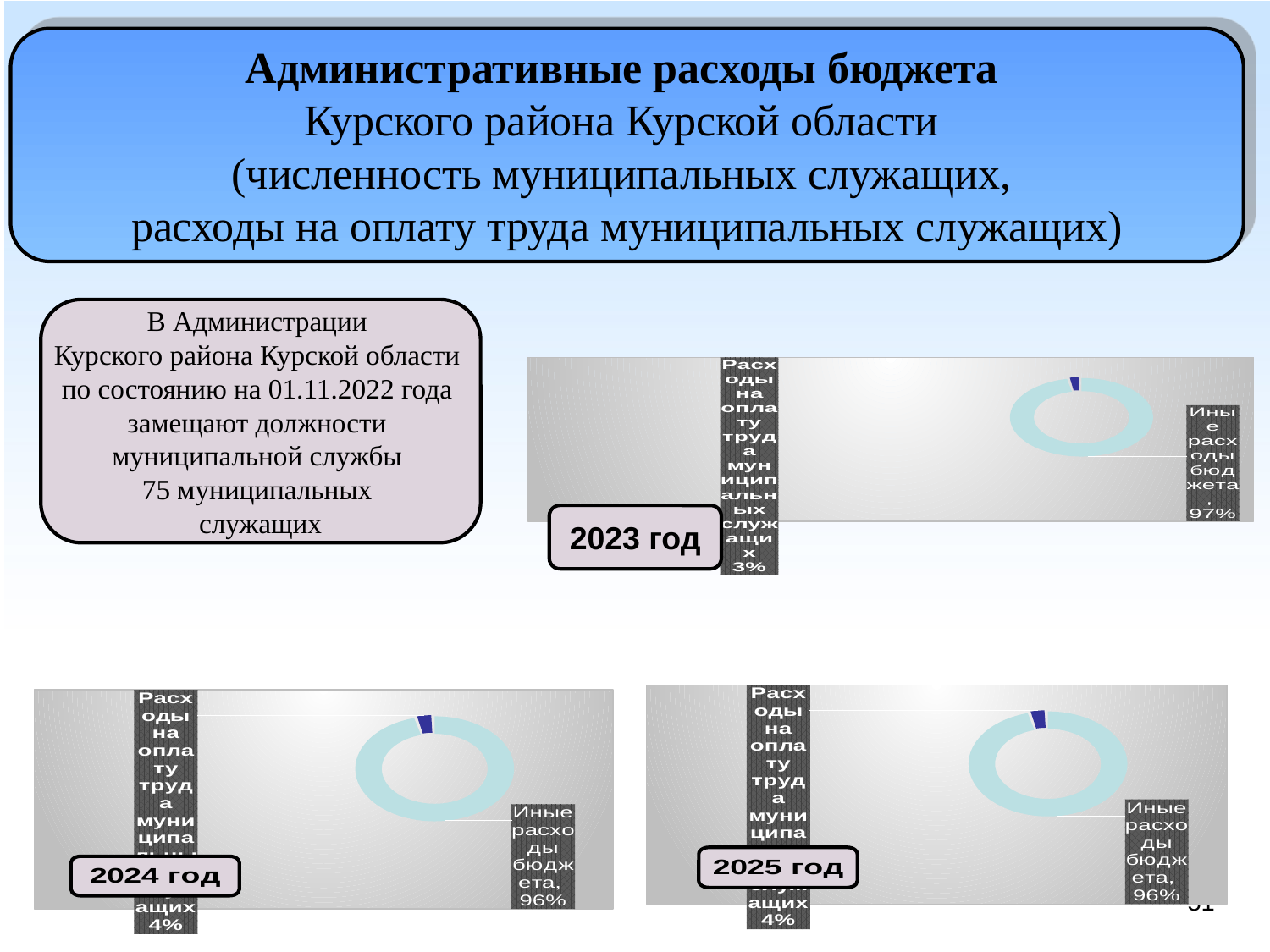
In the 2023 год chart, what share is labelled for Иные расходы бюджета? 97% In the 2024 год chart, what is the difference between the shares of Иные расходы бюджета and Расходы на оплату труда муниципальных служащих? 92% In the 2024 год chart, what share is labelled for Иные расходы бюджета? 96% In the 2023 год chart, which slice is the largest? Иные расходы бюджета In the 2024 год chart, what share is labelled for Расходы на оплату труда муниципальных служащих? 4% In the 2025 год chart, which slice is the smallest? Расходы на оплату труда муниципальных служащих In the 2025 год chart, what share is labelled for Иные расходы бюджета? 96% What kind of chart is used for the 2024 год chart? Doughnut (pie) chart How many slices does the 2025 год chart have? 2 How many charts are shown on the slide? 3 In the 2023 год chart, what share is labelled for Расходы на оплату труда муниципальных служащих? 3% In the 2025 год chart, what share is labelled for Расходы на оплату труда муниципальных служащих? 4%